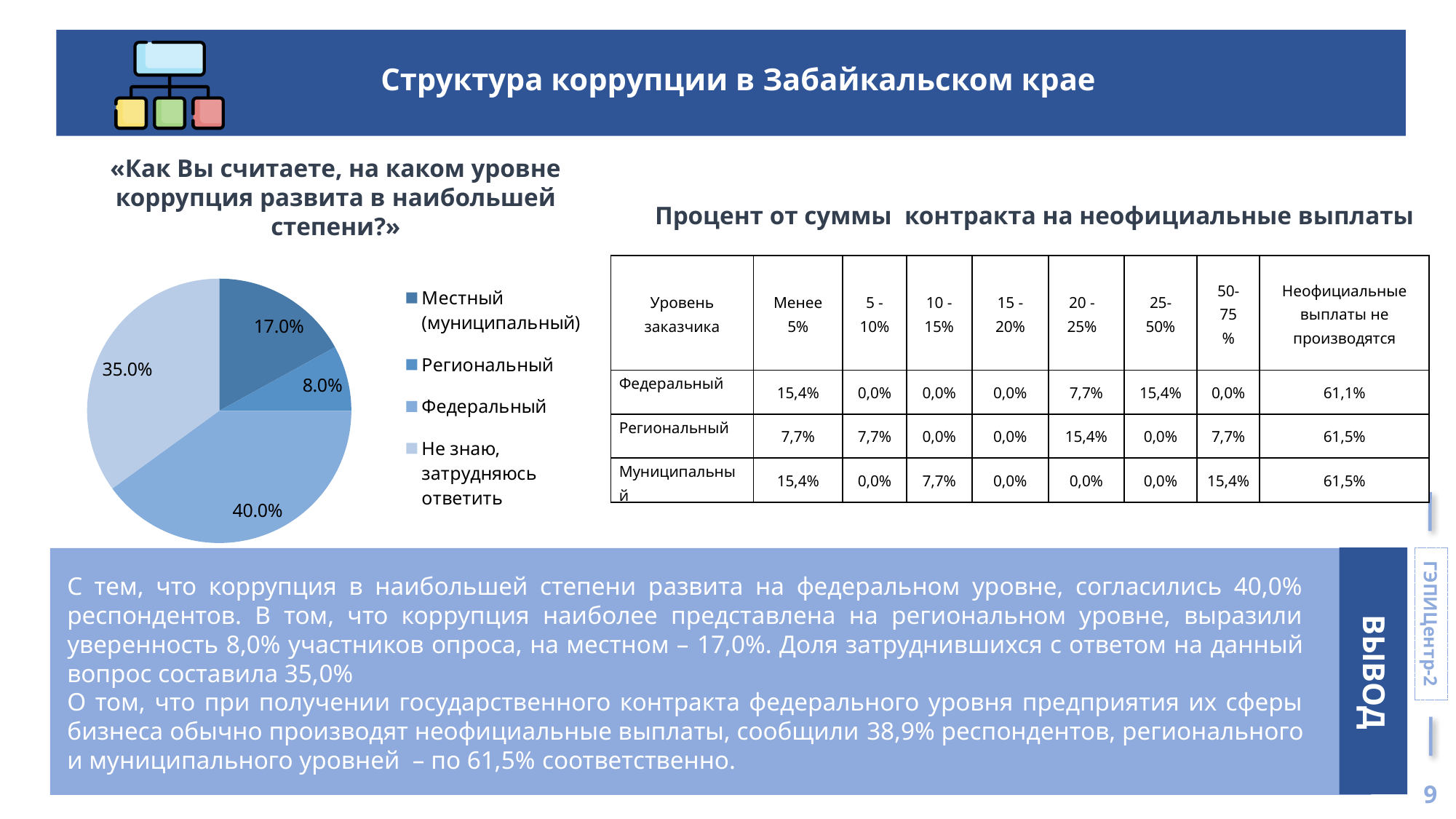
Which category has the largest slice in the pie chart? Федеральный In the pie chart, what is the value for Не знаю, затрудняюсь ответить? 35.0% In the pie chart, which is larger: Местный (муниципальный) or Региональный? Местный (муниципальный) How many slices does the pie chart have? 4 In the pie chart, what is the value for Федеральный? 40.0% In the pie chart, what is the difference between the values for Федеральный and Не знаю, затрудняюсь ответить? 5.0% Which category has the smallest slice in the pie chart? Региональный In the pie chart, what is the value for Региональный? 8.0% What kind of chart is shown on the left of the slide? pie chart In the pie chart, what is the value for Местный (муниципальный)? 17.0% In the pie chart, what is the combined value of Местный (муниципальный) and Региональный? 25.0% How many entries does the pie chart's legend list? 4